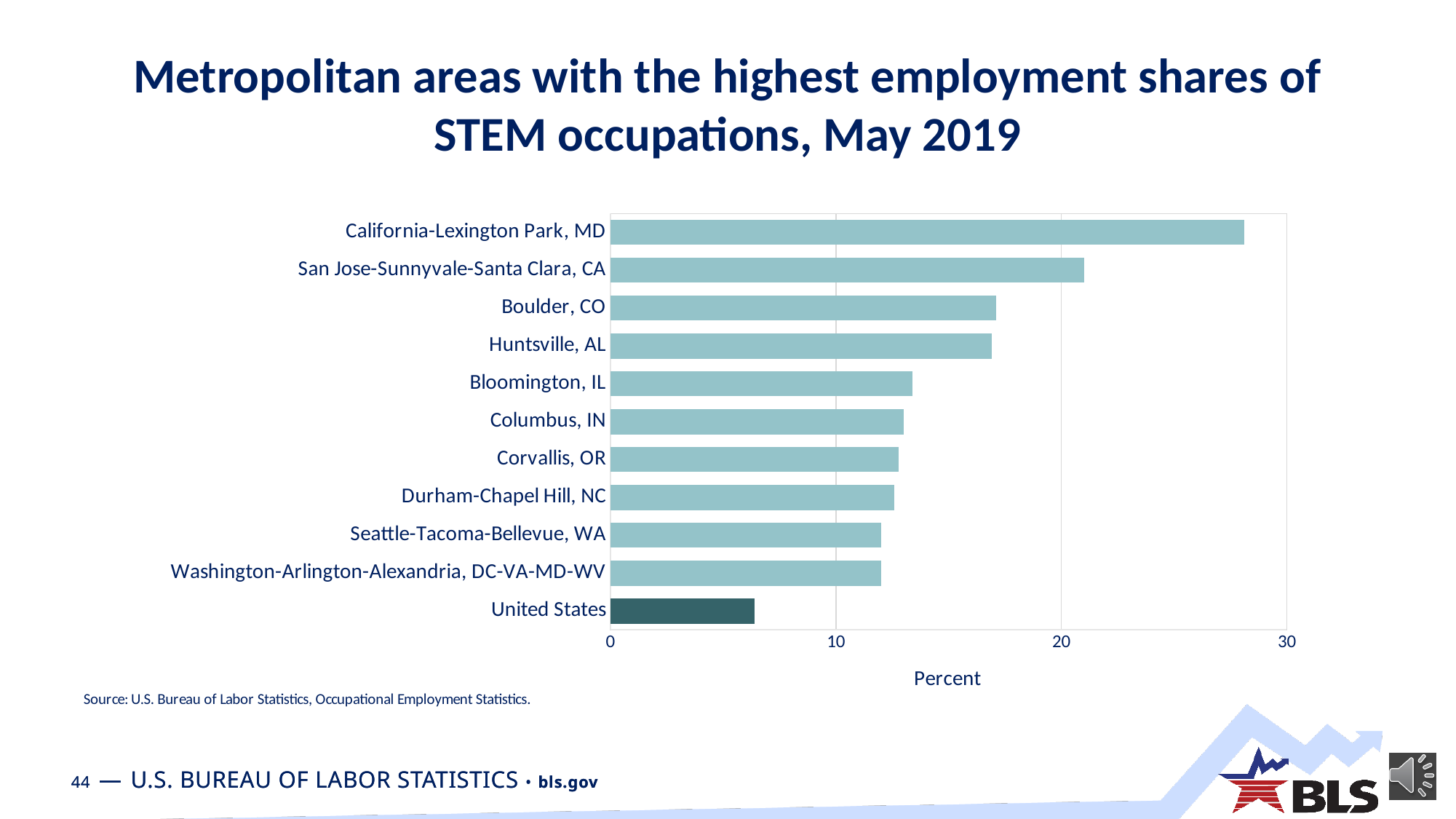
Is the value for United States greater or less than 10? less Is the value for California-Lexington Park, MD greater or less than 20? greater Is the value for Boulder, CO greater or less than 20? less How many bars (categories) are plotted in the chart? 11 Which has a larger value, California-Lexington Park, MD or San Jose-Sunnyvale-Santa Clara, CA? California-Lexington Park, MD What is the label on the horizontal axis of the chart? Percent Which bar in the chart is shown in a darker colour than the others? United States Which category has the shortest bar in the chart? United States Which metropolitan area has the highest employment share of STEM occupations in the chart? California-Lexington Park, MD What kind of chart is shown on the slide? Bar chart